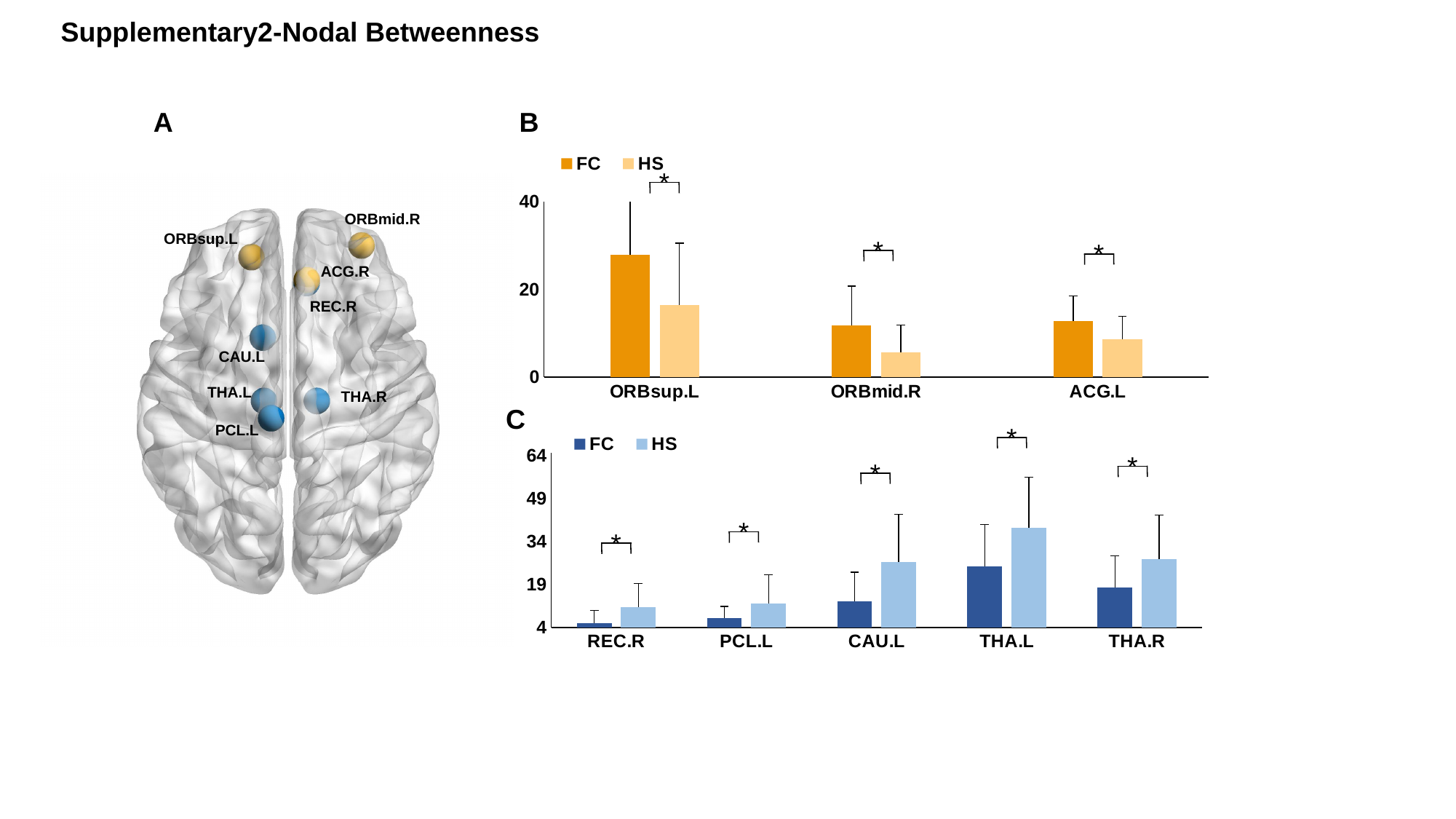
In chart B (the orange chart), is the FC value for ORBsup.L greater or less than 20? greater In chart B (the orange chart), which category has the highest FC value? ORBsup.L In chart C (the blue chart), how many categories are shown on the x axis? 5 In chart B (the orange chart), is the HS value for ORBmid.R greater or less than 20? less In chart B (the orange chart), which is larger for ORBsup.L, FC or HS? FC In chart C (the blue chart), which category has the highest HS value? THA.L In chart C (the blue chart), which is larger for CAU.L, FC or HS? HS In chart C (the blue chart), which category has the lowest FC value? REC.R In chart B (the orange chart), how many categories are shown on the x axis? 3 In chart C (the blue chart), is the HS value for THA.L greater or less than 34? greater In chart B (the orange chart), how many series does the legend list? 2 What kind of chart is chart B (the orange chart)? bar chart